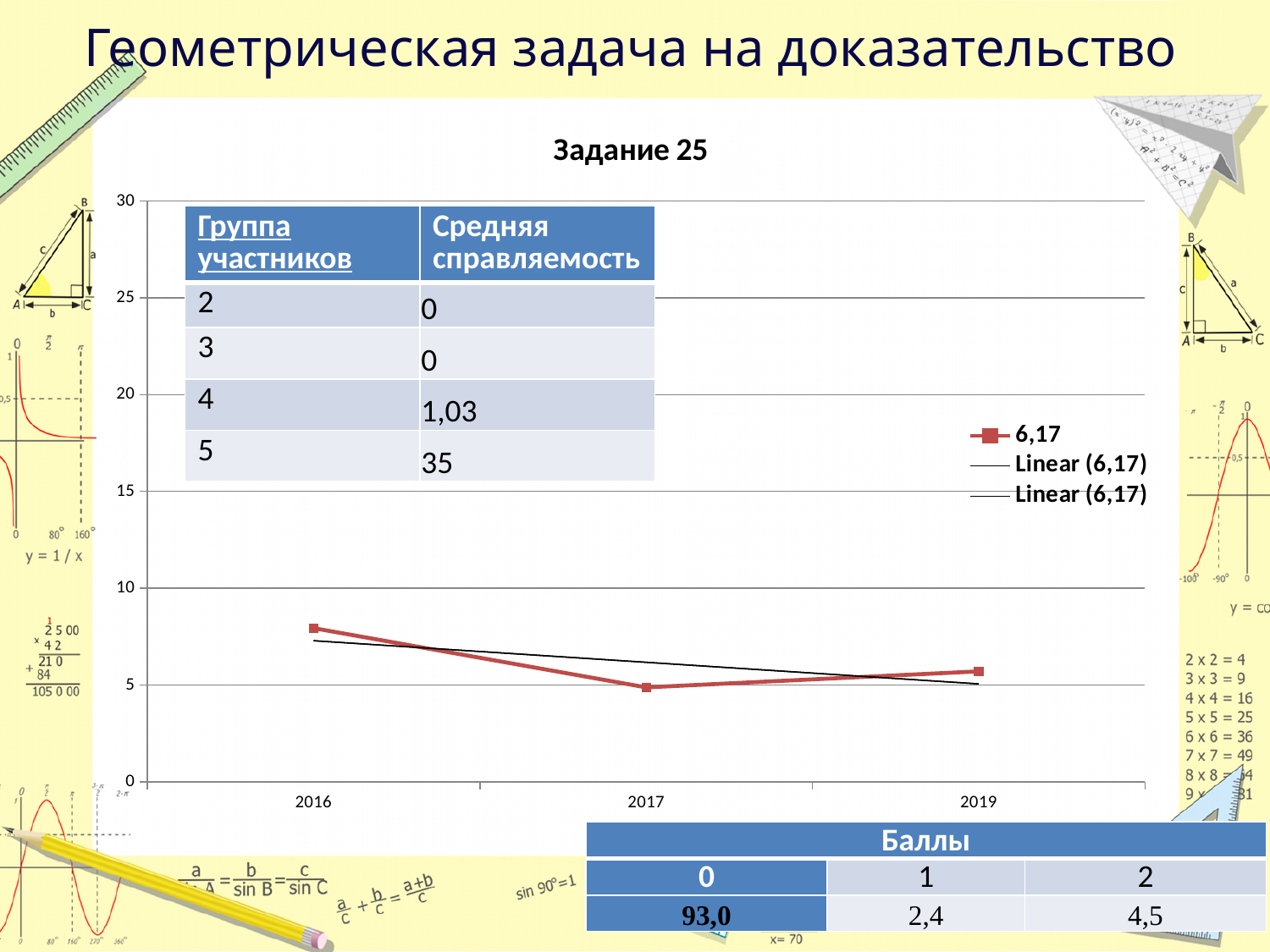
How many entries does the chart legend list? 3 How many data points are plotted on the line for series 6,17? 3 What kind of chart is shown on the slide? line chart Is the value for 2016 greater or less than 5? greater Does the 6,17 line rise or fall from 2016 to 2017? fall What is the title of the chart? Задание 25 Is the value for 2016 greater or less than 10? less Which is larger, the value for 2016 or the value for 2019? 2016 Is the value for 2017 greater or less than 10? less Which year has the lowest value on the 6,17 line? 2017 Which year has the highest value on the 6,17 line? 2016